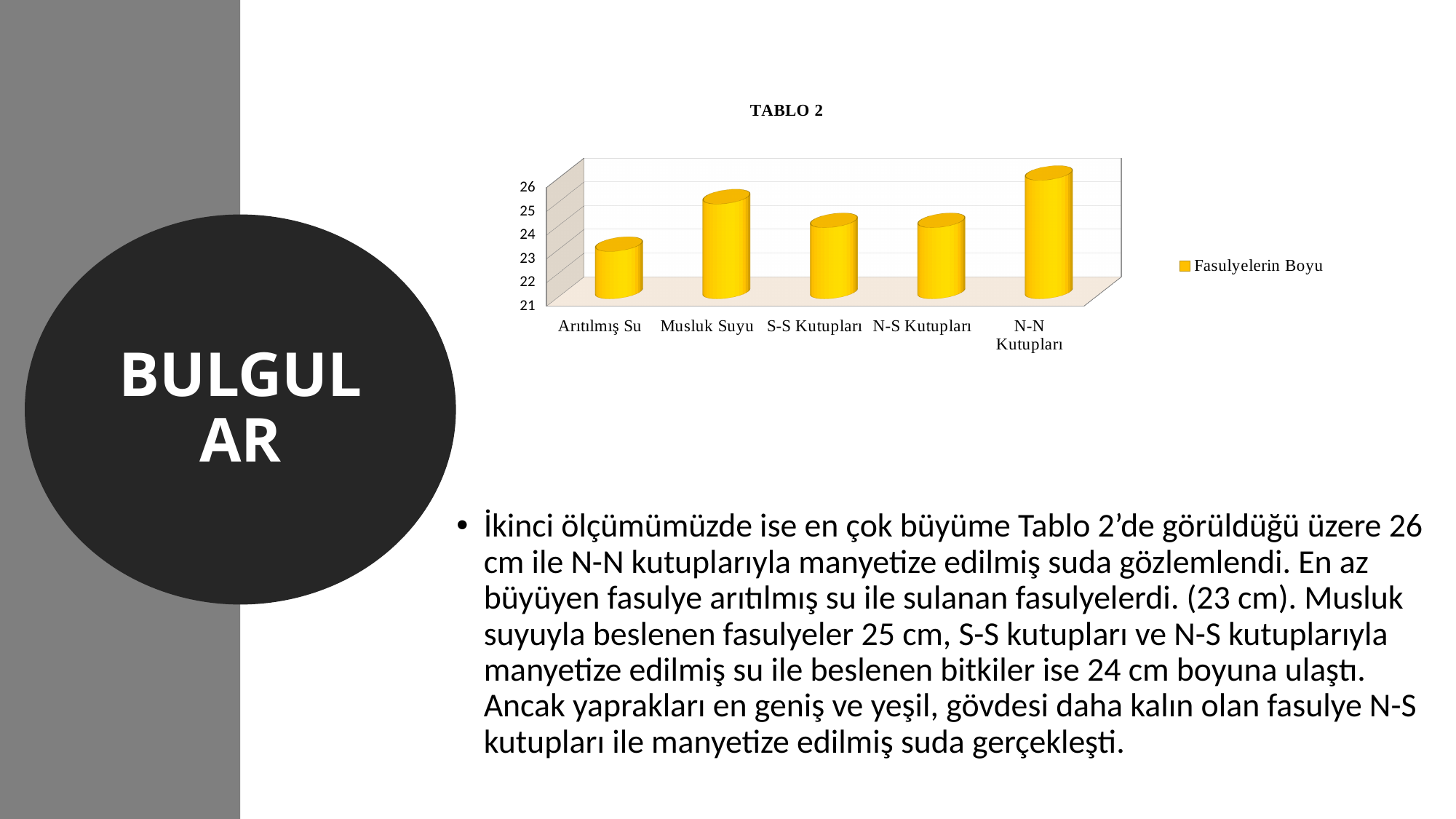
What is the name of the series shown in the chart legend? Fasulyelerin Boyu How many categories are shown on the x axis of the chart? 5 Which is larger in the chart, the value for Musluk Suyu or the value for S-S Kutupları? Musluk Suyu Is the value for S-S Kutupları greater or less than 25? less Is the value for N-N Kutupları greater or less than 25? greater Is the value for Musluk Suyu greater or less than 24? greater What kind of chart is shown under the title TABLO 2? bar chart How many series does the chart legend list? 1 Which category has the lowest bar in the chart? Arıtılmış Su What is the title of the chart on the slide? TABLO 2 Which category has the highest bar in the chart? N-N Kutupları